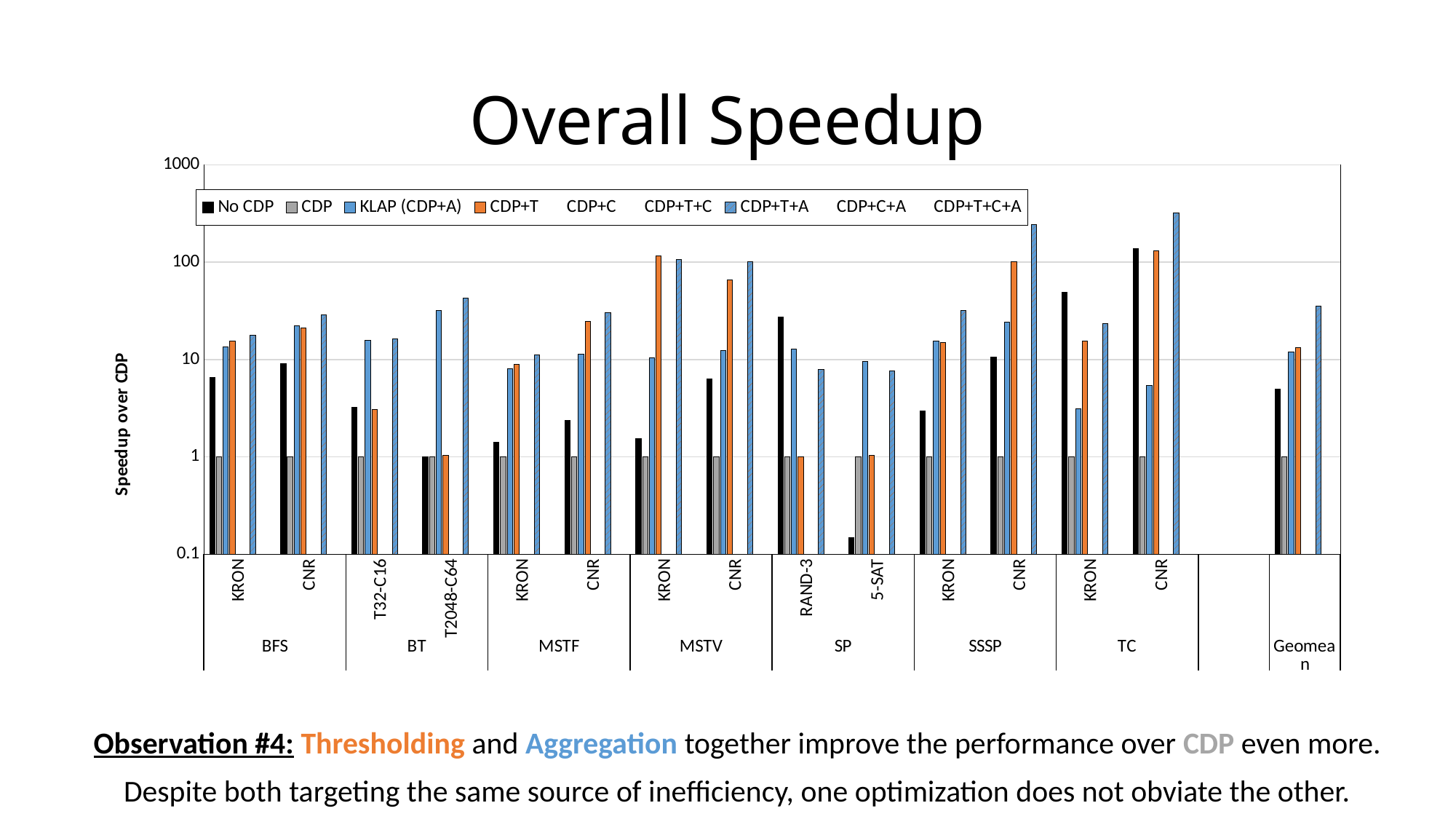
What kind of chart is shown on the slide? bar chart Is the CDP+T+A value for Geomean greater or less than 10? greater How many benchmark groups (including Geomean) are shown along the x axis? 8 Is the CDP+T+A value for TC CNR greater or less than 100? greater What is the label of the vertical axis? Speedup over CDP What is the value of the CDP bar for BFS KRON? 1 Which benchmark and series has the highest bar in the chart? CDP+T+A for TC CNR Is the CDP+T value for MSTV KRON greater or less than 100? greater What is the title of the chart? Overall Speedup How many series does the legend list? 9 For TC CNR, which is larger: the No CDP value or the KLAP (CDP+A) value? No CDP